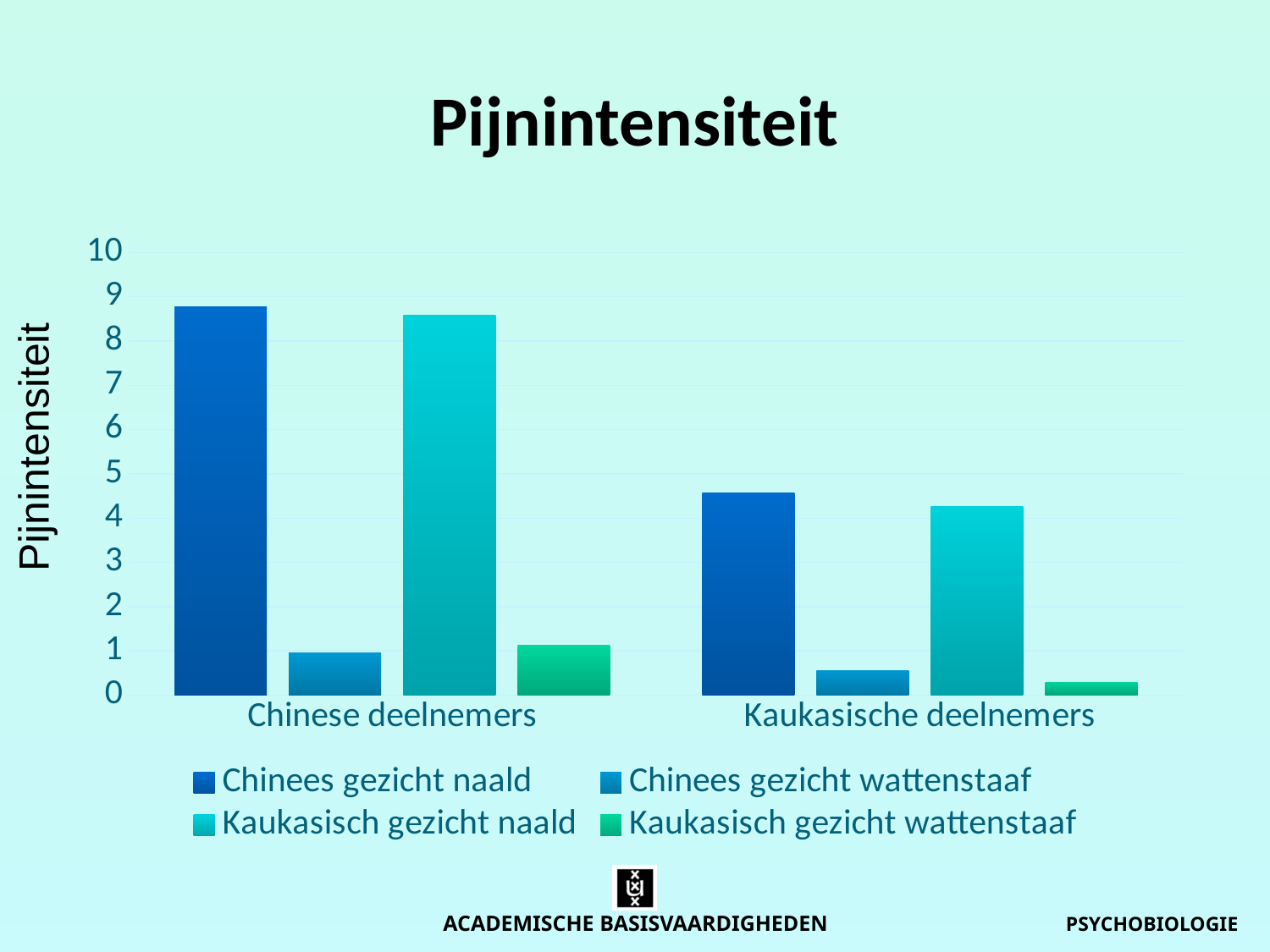
Is the value for Chinees gezicht naald among Kaukasische deelnemers greater or less than 4? greater Is the value for Chinees gezicht wattenstaaf among Kaukasische deelnemers greater or less than 1? less How many series does the legend list? 4 What is the title of the chart? Pijnintensiteit Is the value for Chinees gezicht naald among Chinese deelnemers greater or less than 8? greater What is the label of the y axis? Pijnintensiteit Among Chinese deelnemers, which is larger: Kaukasisch gezicht naald or Kaukasisch gezicht wattenstaaf? Kaukasisch gezicht naald What kind of chart is shown on the slide? bar chart Which is larger: Chinees gezicht naald for Chinese deelnemers or Chinees gezicht naald for Kaukasische deelnemers? Chinese deelnemers How many participant groups are shown on the x axis? 2